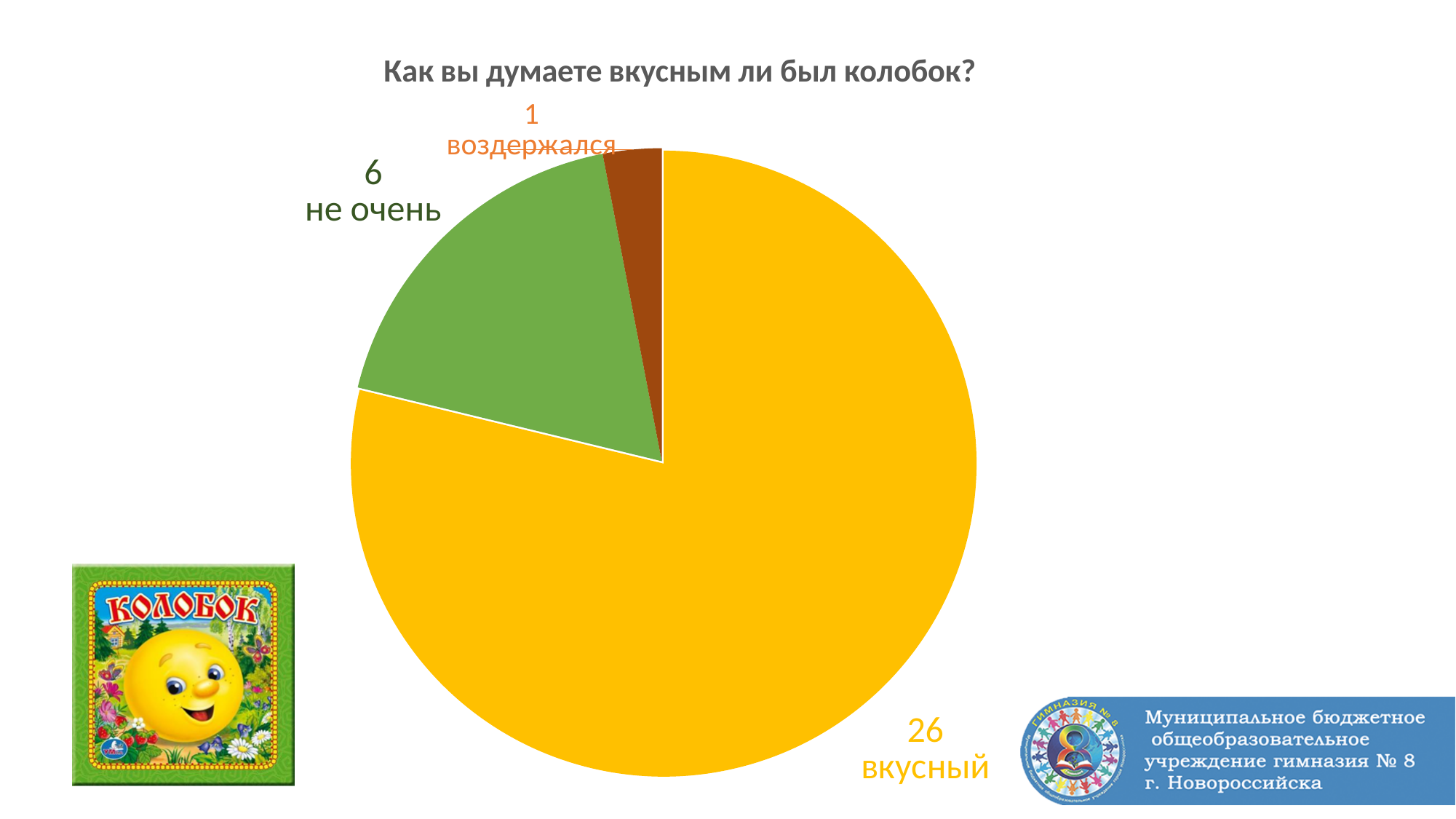
Which is larger, the value for "не очень" or the value for "воздержался"? не очень Which category has the largest slice? вкусный What kind of chart is shown on the slide? pie chart What is the value for "вкусный"? 26 What is the difference between the values for "не очень" and "воздержался"? 5 What is the value for "воздержался"? 1 Which category has the smallest slice? воздержался What is the value for "не очень"? 6 What is the title of the chart? Как вы думаете вкусным ли был колобок? What is the difference between the values for "вкусный" and "не очень"? 20 How many slices does the pie chart have? 3 What colour is the slice for "вкусный"? yellow